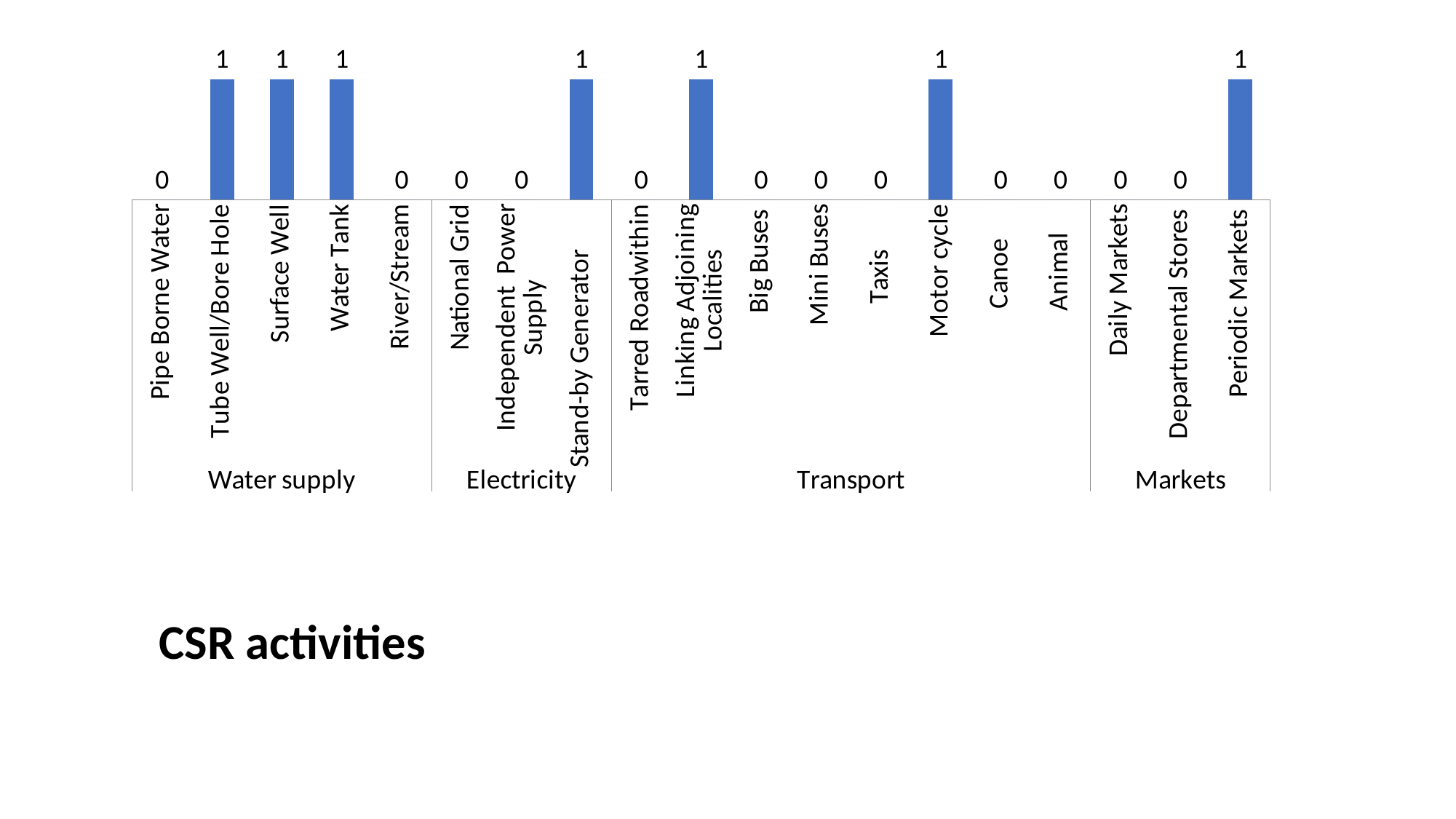
Which category in the Electricity group has the highest value? Stand-by Generator Which category in the Markets group has the highest value? Periodic Markets What is the value for Periodic Markets? 1 How many category groups are labelled along the bottom of the chart? 4 What is the value for Taxis? 0 What is the value for Pipe Borne Water? 0 What is the difference between the values for Motor cycle and Canoe? 1 What kind of chart is shown on the slide? Bar chart What is the value for Tube Well/Bore Hole? 1 How many categories are shown on the x axis? 19 Which is larger, the value for Water Tank or the value for River/Stream? Water Tank What is the value for Stand-by Generator? 1